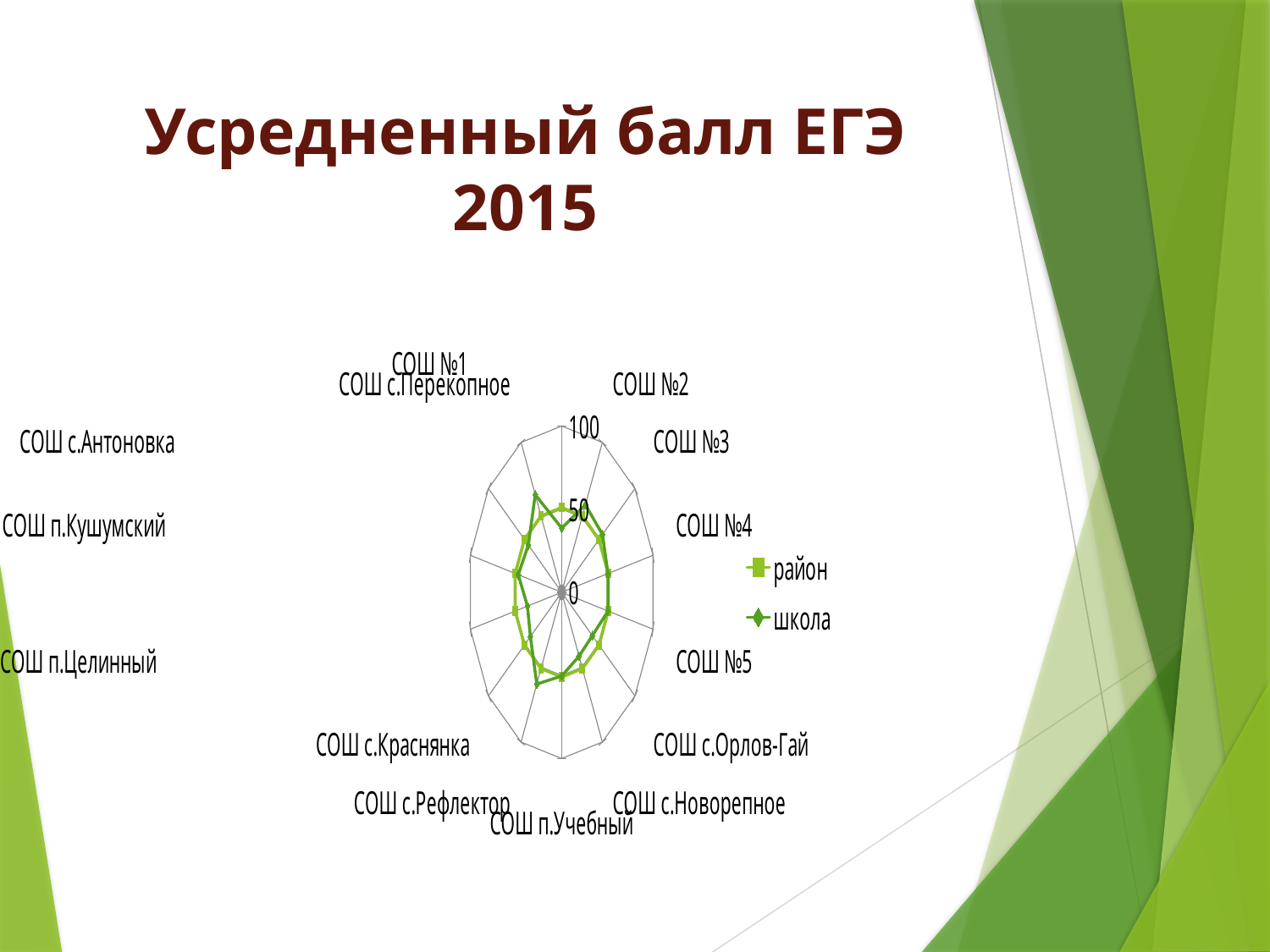
How many series does the legend list? 2 Is the value for СОШ с.Краснянка in the район series greater or less than 100? less What are the two series named in the legend? район and школа How many schools (categories) are plotted on the radar chart? 14 What kind of chart is shown on the slide? radar chart What is the title of the slide containing the chart? Усредненный балл ЕГЭ 2015 Is the value for СОШ №4 in the район series greater or less than 100? less What is the highest value shown on the radial axis of the chart? 100 Is the value for СОШ №1 in the школа series greater or less than 100? less